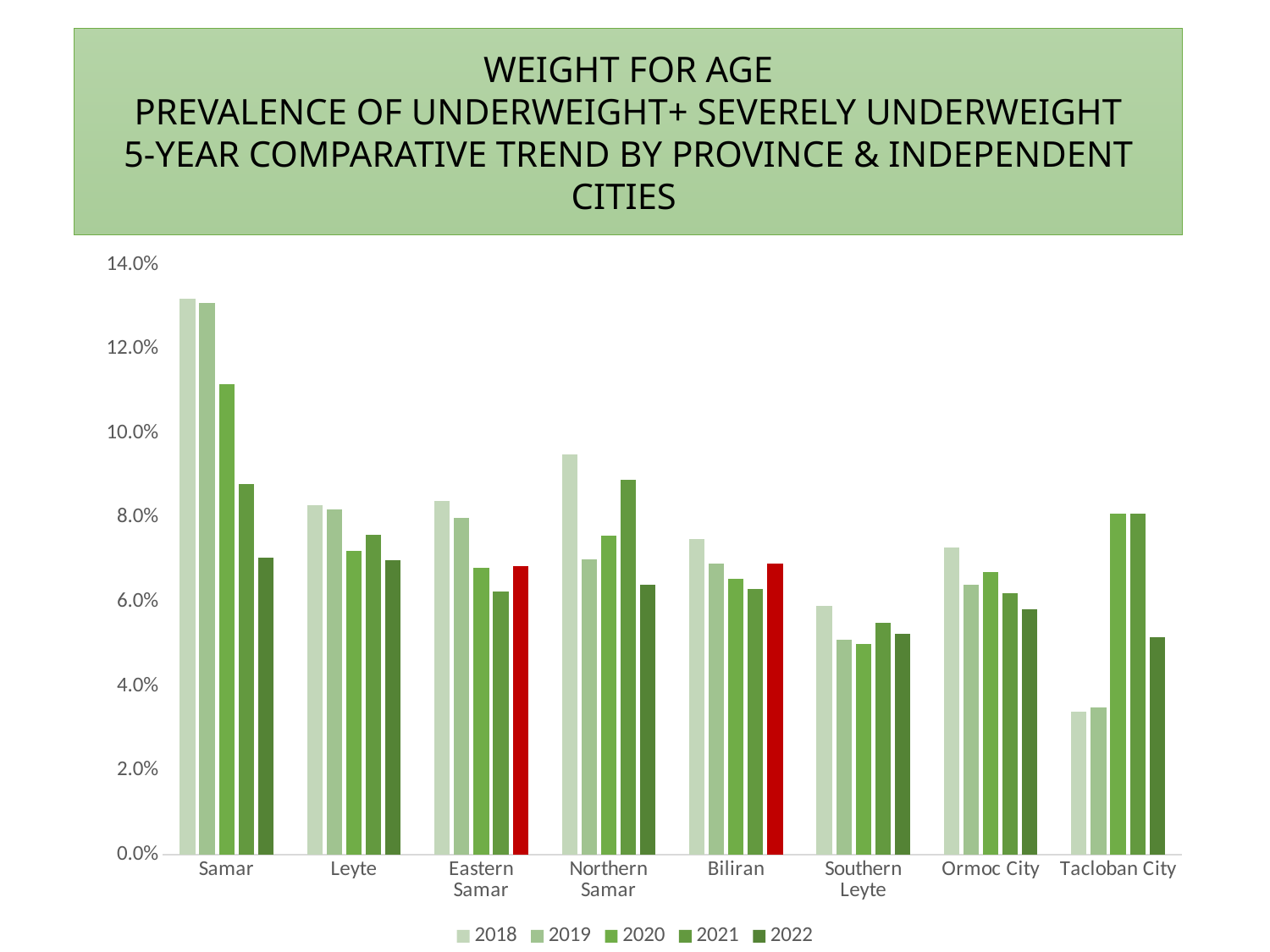
Which is larger, the 2022 value for Samar or the 2022 value for Southern Leyte? Samar Is the 2018 value for Tacloban City greater or less than 4.0%? less How many provinces and cities are shown on the x axis? 8 Which province or city has the highest 2018 value? Samar What kind of chart is shown on the slide? bar chart How many series does the legend list? 5 Is the 2020 value for Southern Leyte greater or less than 6.0%? less Which two bars are coloured red instead of green? Eastern Samar 2022 and Biliran 2022 Is the 2021 value for Northern Samar greater or less than 8.0%? greater Which province or city has the lowest 2018 value? Tacloban City Do the values for Samar rise or fall from 2018 to 2022? fall